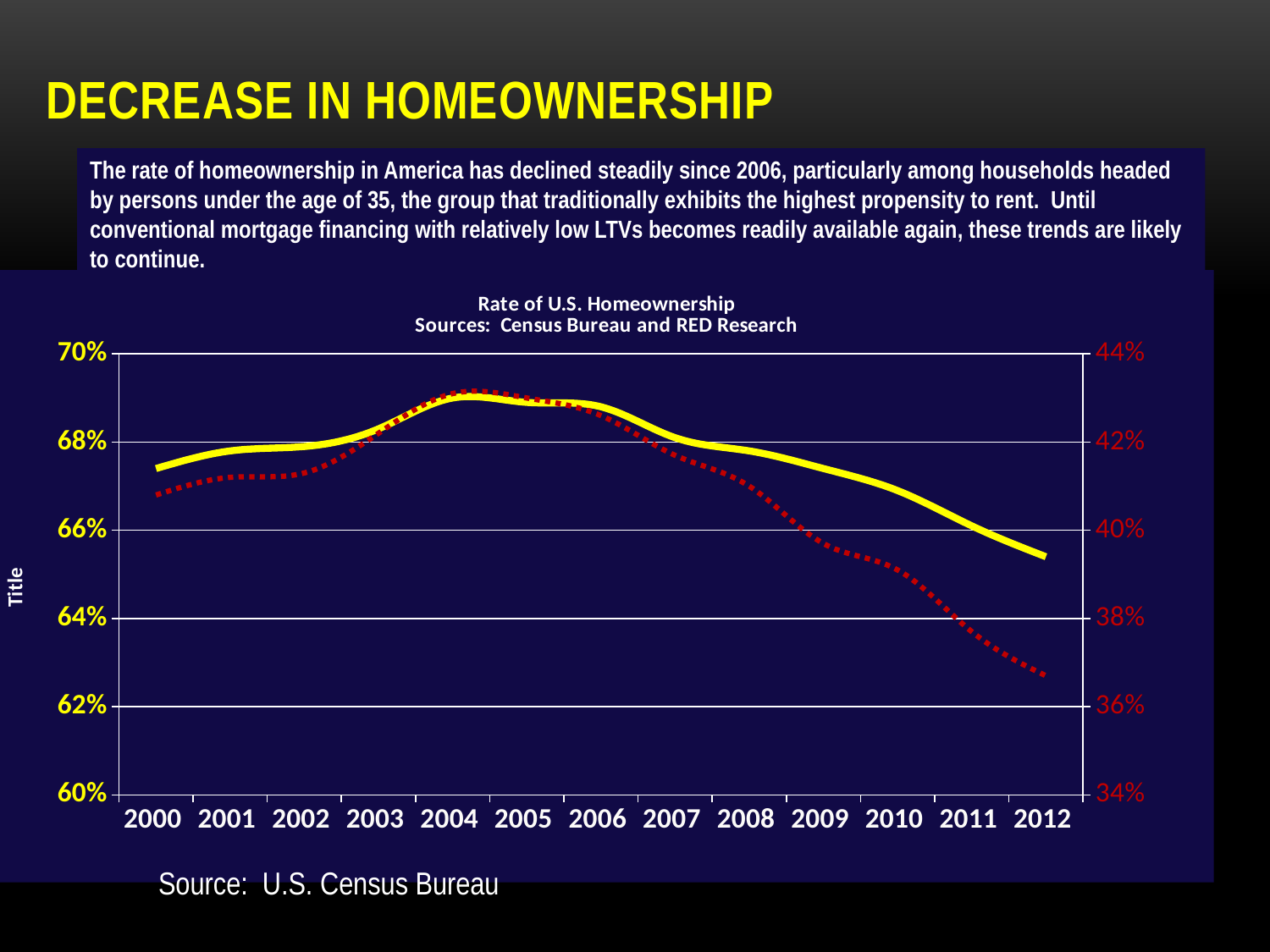
What is the title of the chart? Rate of U.S. Homeownership In which year does the solid yellow line reach its lowest value? 2012 What kind of chart is shown on the slide? line chart Is the solid yellow line higher in 2006 or in 2010? 2006 How many lines are plotted on the chart? 2 Is the value of the solid yellow line in 2012 greater or less than 66%? less On the right-hand axis, is the value of the red dotted line in 2012 greater or less than 38%? less Is the value of the solid yellow line in 2004 greater or less than 68%? greater Does the solid yellow line rise or fall from 2006 to 2012? fall How many years are shown along the x axis of the chart? 13